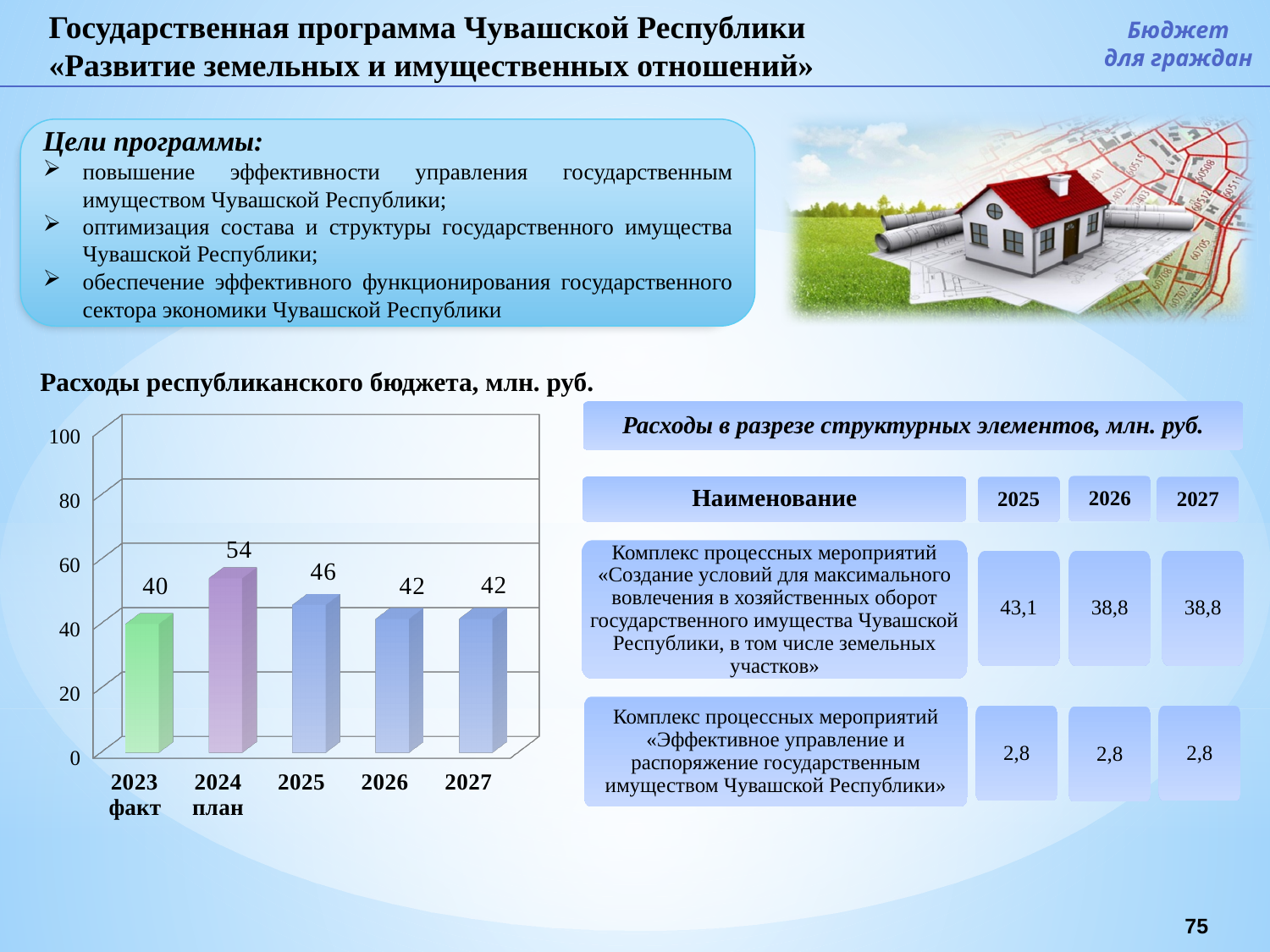
What is the value for 2024 план in the chart 'Расходы республиканского бюджета, млн. руб.'? 54 What is the title of the chart on the slide? Расходы республиканского бюджета, млн. руб. How many categories are shown on the x axis of the chart? 5 What kind of chart is shown on the slide? bar chart What is the value for 2023 факт in the chart? 40 What is the difference between the values for 2025 and 2026? 4 Which is larger, the value for 2025 or the value for 2027? 2025 What is the value for 2025 in the chart? 46 Which category has the lowest value in the chart? 2023 факт Which category has the highest value in the chart? 2024 план What is the value for 2027 in the chart? 42 What is the difference between the values for 2024 план and 2023 факт? 14